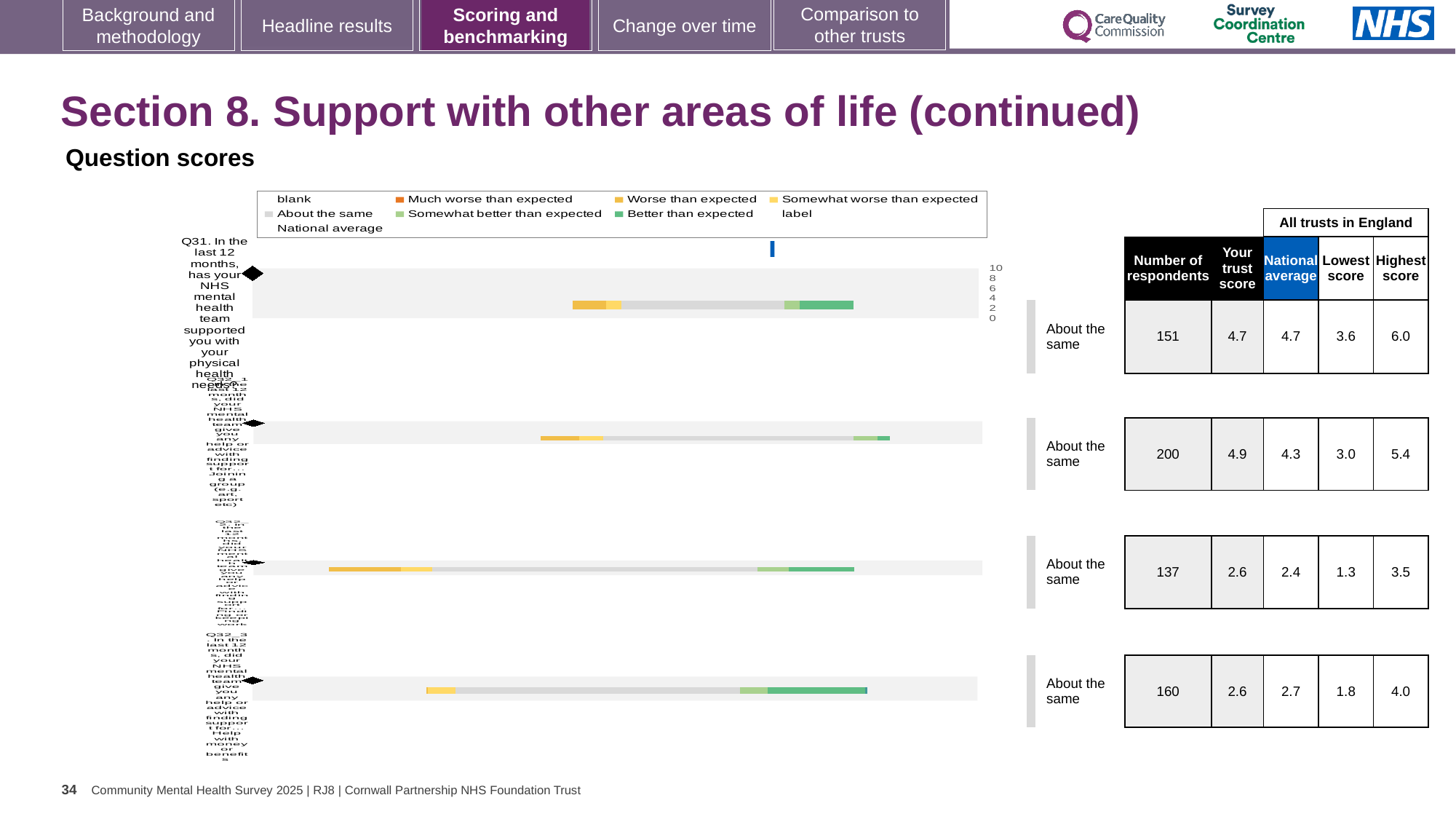
How many question bars are plotted in the chart? 4 What is the lowest score across all trusts in England for the third row of the table? 1.3 What is the trust score for Q31 (support with physical health needs)? 4.7 What benchmark category is shown next to each of the four bars? About the same What is the smallest value in the 'Highest score' column of the table? 3.5 What kind of chart is shown on the slide? Bar chart For the second row (Q32_1, help finding support for joining a group), which is larger: the trust score or the national average? Trust score What is the number of respondents for Q31 (support with physical health needs)? 151 What is the national average for the last row (Q32_3, help with money or benefits)? 2.7 How many entries does the chart legend list? 9 What is the difference between the highest score (6.0) and the lowest score (3.6) for Q31? 2.4 What is the largest number of respondents shown in the table? 200